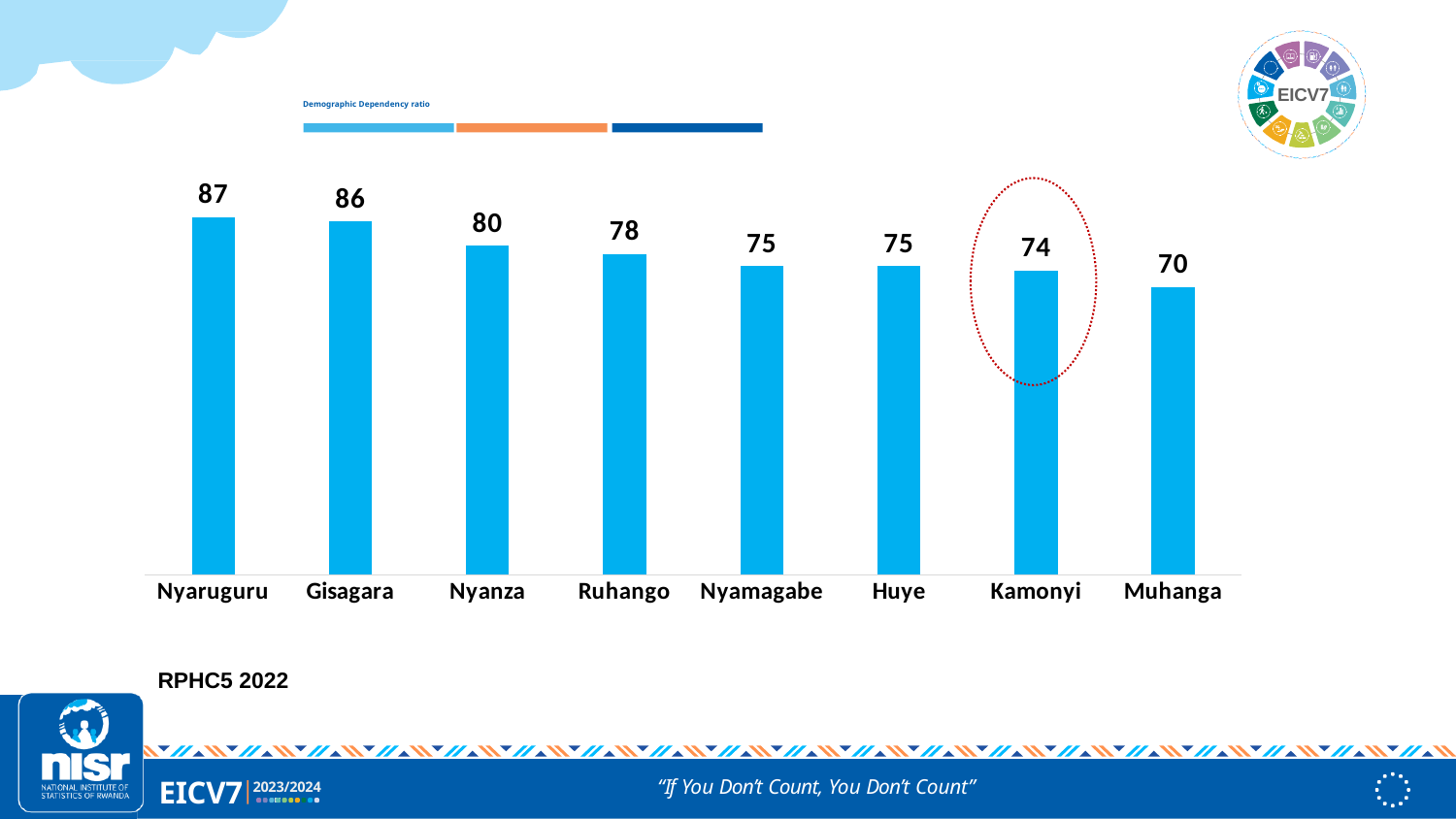
Which has a larger value, Nyanza or Kamonyi? Nyanza How many districts are shown in the chart? 8 What kind of chart is shown on the slide? Bar chart Which district has the highest demographic dependency ratio? Nyaruguru Do the values rise or fall from left to right across the districts? Fall What is the demographic dependency ratio for Nyaruguru? 87 What is the difference between the values for Gisagara and Ruhango? 8 Which district has the lowest demographic dependency ratio? Muhanga What is the value shown for Kamonyi? 74 What is the value shown for Nyanza? 80 What is the difference between the values for Nyaruguru and Muhanga? 17 Which district's bar is highlighted with a red dotted circle? Kamonyi